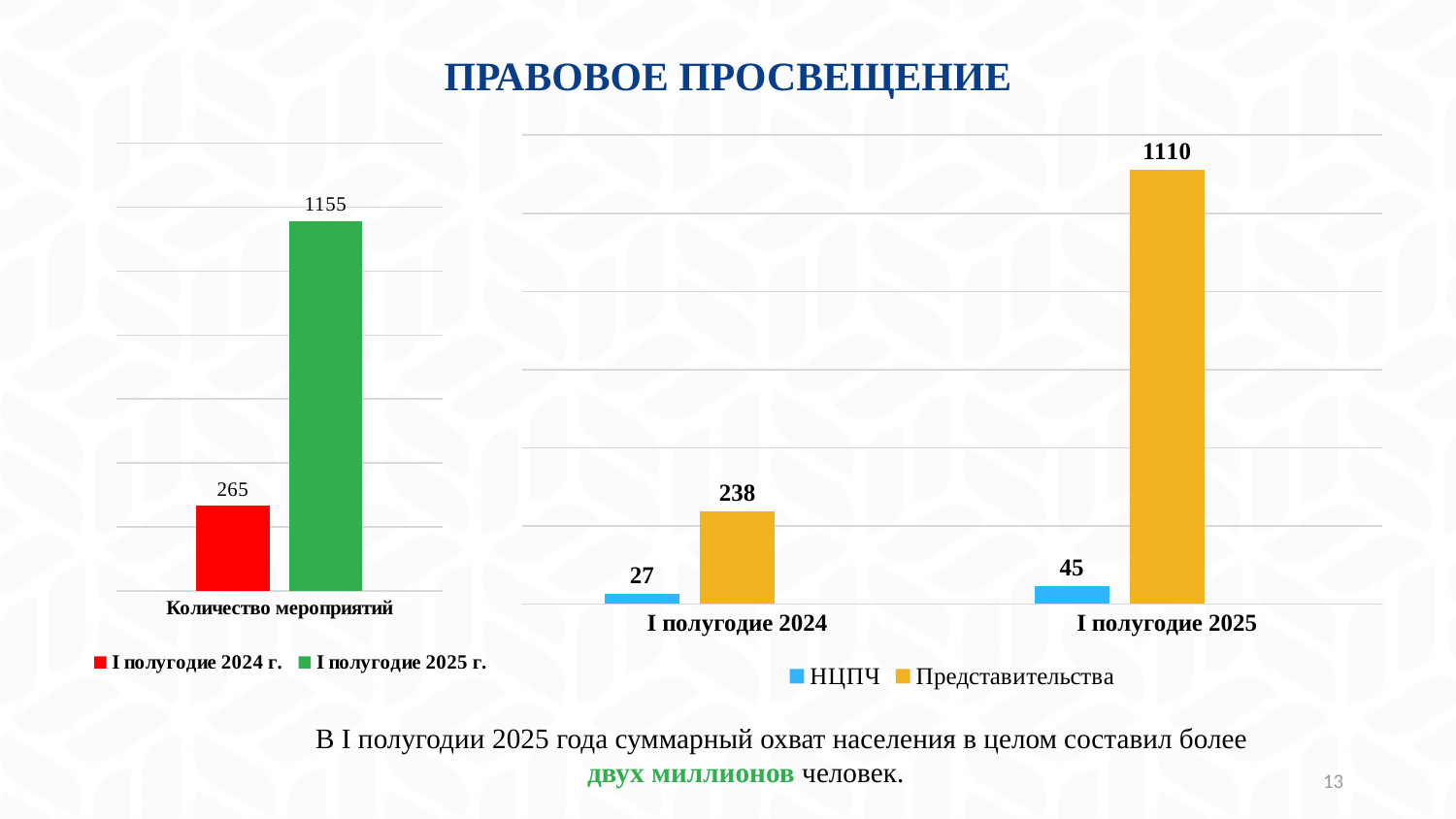
In the right chart, what is the value for НЦПЧ in I полугодие 2025? 45 In the right chart, which series has the highest value overall? Представительства In the right chart, what is the value for Представительства in I полугодие 2024? 238 In the right chart, what is the value for Представительства in I полугодие 2025? 1110 In the right chart, what is the difference between the Представительства values for I полугодие 2025 and I полугодие 2024? 872 In the left chart, what is the difference between the I полугодие 2025 г. and I полугодие 2024 г. values? 890 In the left chart, what is the value for I полугодие 2024 г. for Количество мероприятий? 265 In the right chart, how many series does the legend list? 2 In the right chart, what is the value for НЦПЧ in I полугодие 2024? 27 What kind of chart is the right chart? Bar chart In the left chart, what is the value for I полугодие 2025 г. for Количество мероприятий? 1155 In the left chart, which series has the larger value: I полугодие 2024 г. or I полугодие 2025 г.? I полугодие 2025 г.